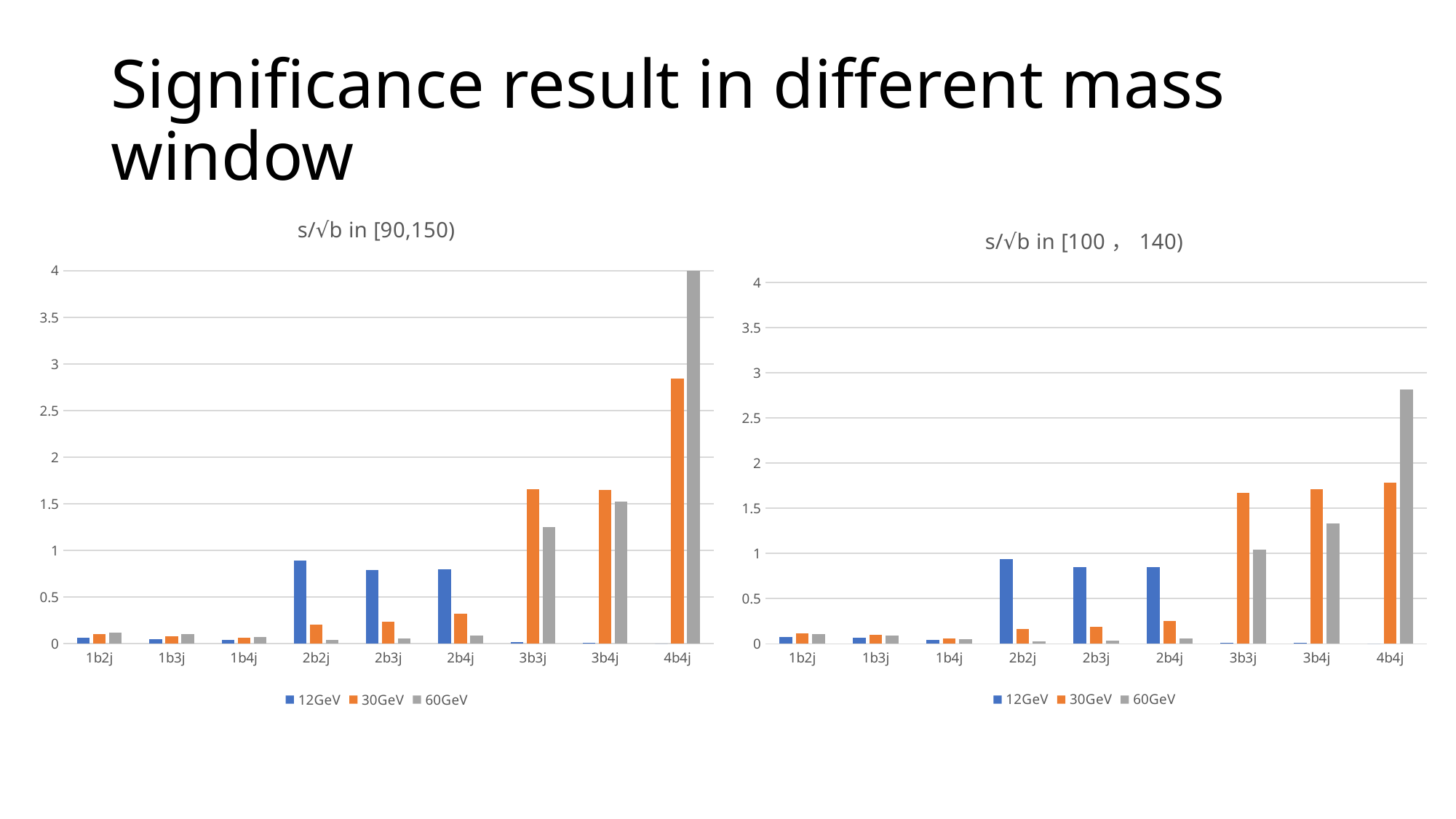
In the right chart "s/√b in [100，140)", which category has the tallest bar overall? 4b4j What kind of chart is the left chart titled "s/√b in [90,150)"? bar chart In the left chart "s/√b in [90,150)", is the 12GeV value for 2b2j greater or less than 1? less In the left chart "s/√b in [90,150)", which is larger at 3b3j: the 30GeV value or the 60GeV value? 30GeV How many categories are shown on the x axis of the right chart titled "s/√b in [100，140)"? 9 In the left chart "s/√b in [90,150)", is the 30GeV value for 4b4j greater or less than 2.5? greater In the right chart "s/√b in [100，140)", is the 60GeV value for 4b4j greater or less than 2.5? greater In the right chart "s/√b in [100，140)", which is larger at 3b4j: the 30GeV value or the 60GeV value? 30GeV In the left chart "s/√b in [90,150)", which series has the tallest bar at 4b4j? 60GeV What are the three legend entries of the right chart "s/√b in [100，140)"? 12GeV, 30GeV, 60GeV How many series does the legend of the left chart "s/√b in [90,150)" list? 3